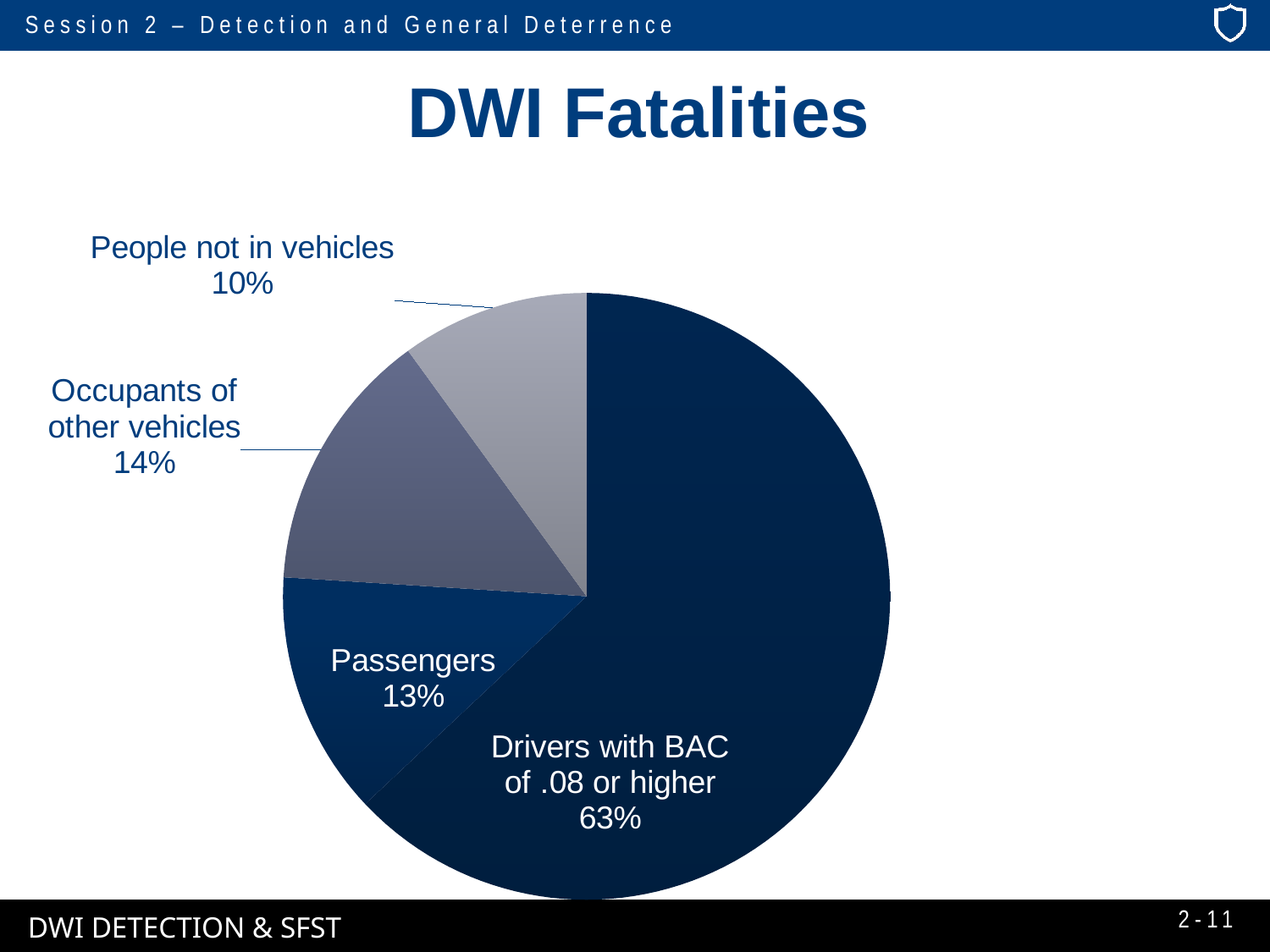
What share of DWI fatalities is People not in vehicles? 10% What share of DWI fatalities is Drivers with BAC of .08 or higher? 63% Which category has the smallest share of the pie? People not in vehicles Which is larger, the share for Occupants of other vehicles or the share for People not in vehicles? Occupants of other vehicles What is the difference in percentage points between Occupants of other vehicles and Passengers? 1 How many categories are shown in the pie chart? 4 What is the title of the chart? DWI Fatalities What type of chart is shown on the slide? pie chart What is the difference in percentage points between Drivers with BAC of .08 or higher and Passengers? 50 What share of DWI fatalities is Passengers? 13% What share of DWI fatalities is Occupants of other vehicles? 14% Which category has the largest share of the pie? Drivers with BAC of .08 or higher